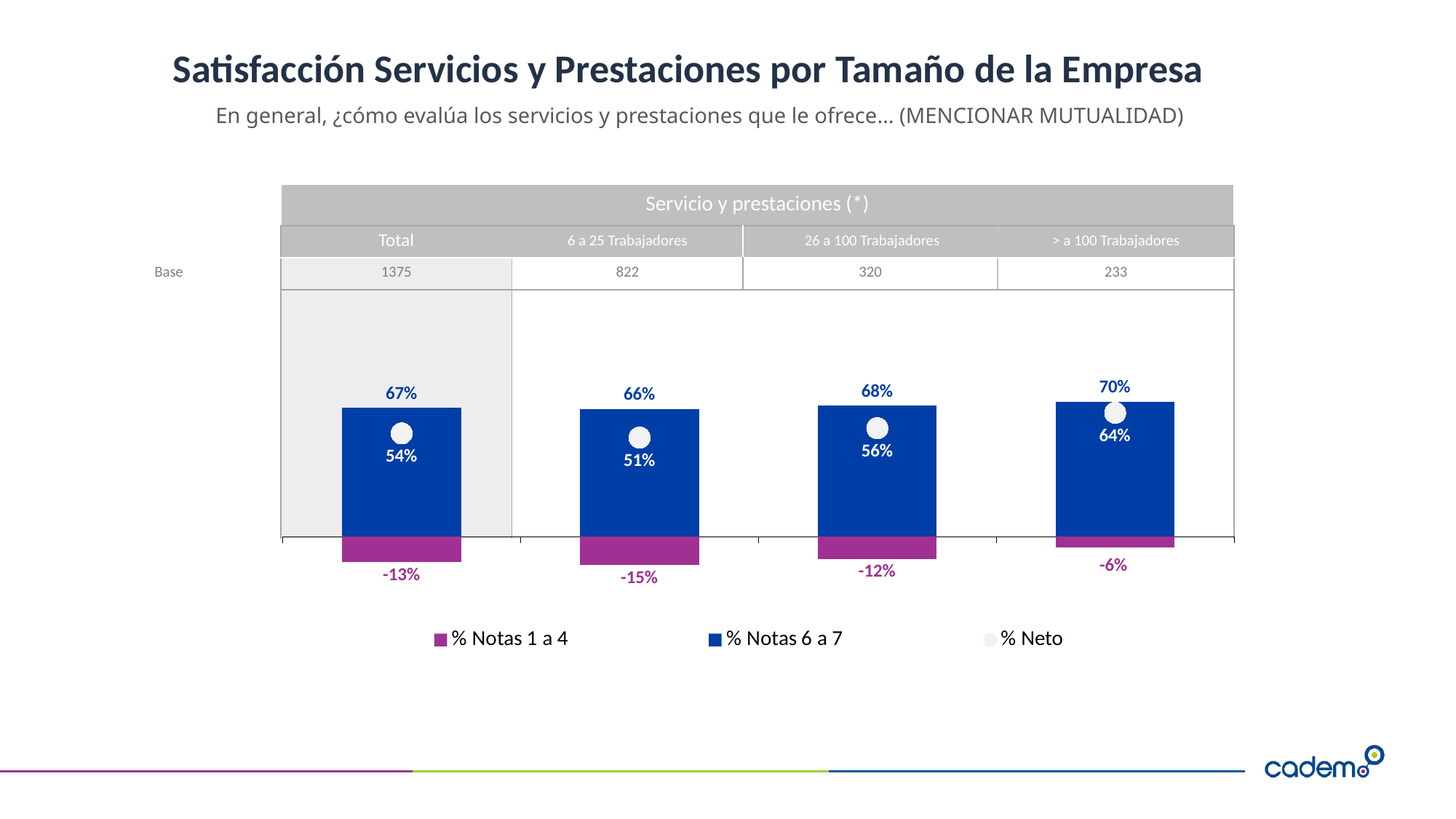
What is the difference between the % Notas 6 a 7 values for > a 100 Trabajadores and 6 a 25 Trabajadores? 4 percentage points Which is larger, the % Neto value for Total or for 26 a 100 Trabajadores? 26 a 100 Trabajadores What is the % Neto value for the 26 a 100 Trabajadores category? 56% Which category has the lowest % Neto value? 6 a 25 Trabajadores What is the % Notas 6 a 7 value for the Total category? 67% What is the % Neto value for the > a 100 Trabajadores category? 64% How many series does the legend list? 3 What kind of chart is shown on the slide? Bar chart What is the % Notas 1 a 4 value for the 6 a 25 Trabajadores category? -15% Which category has the highest % Notas 6 a 7 value? > a 100 Trabajadores How many categories are shown on the x axis of the chart? 4 What is the Base value shown for the 26 a 100 Trabajadores category? 320